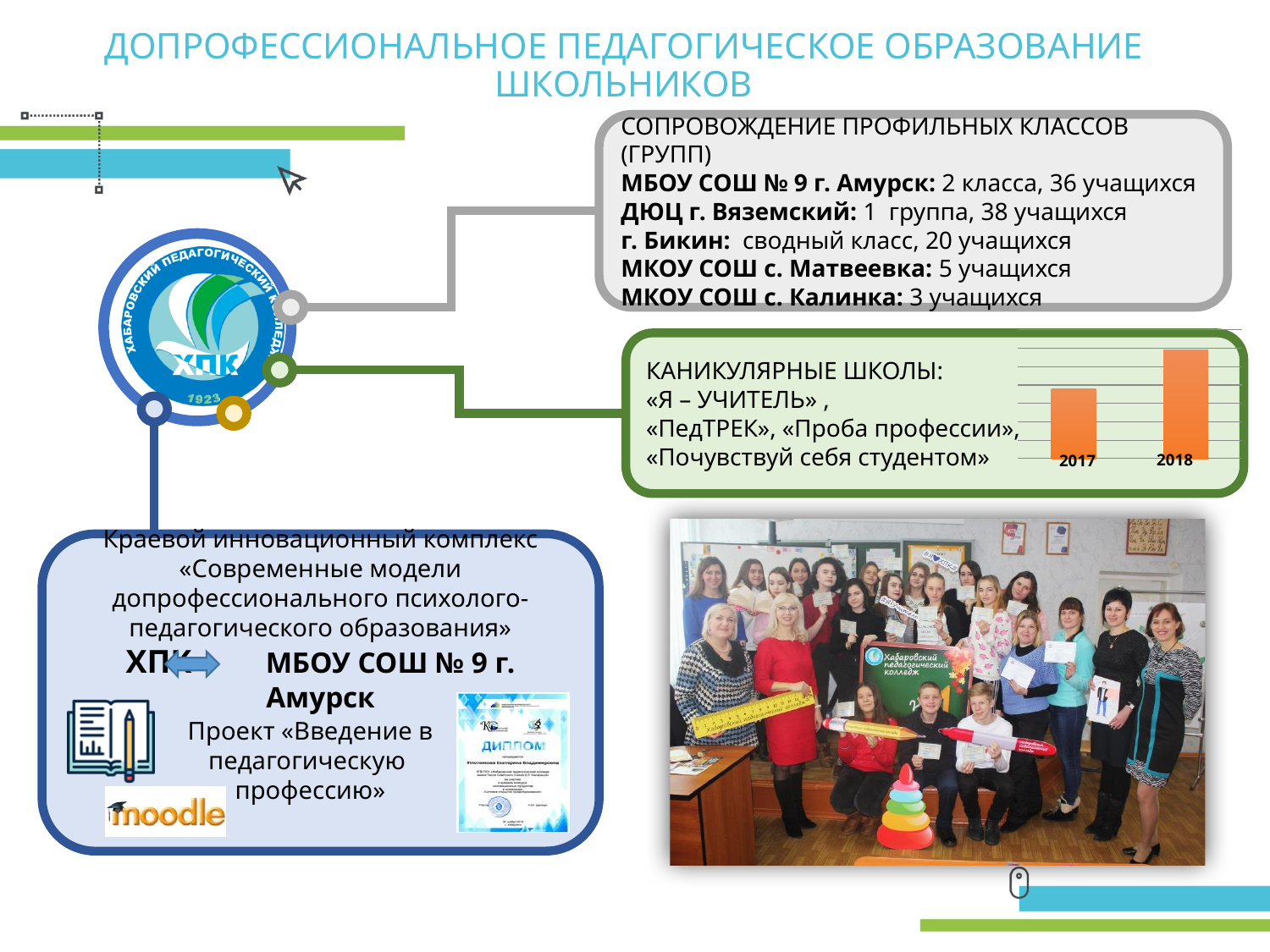
How many categories are shown on the x axis of the bar chart in the green box? 2 What colour are the bars in the bar chart in the green box? orange Which year has the taller bar in the bar chart in the green box? 2018 What are the category labels on the x axis of the bar chart in the green box? 2017 and 2018 In the bar chart in the green box, is the bar for 2018 larger or smaller than the bar for 2017? larger Which year has the shorter bar in the bar chart in the green box? 2017 What kind of chart is shown in the green box about holiday schools (КАНИКУЛЯРНЫЕ ШКОЛЫ)? bar chart Do the values in the bar chart in the green box rise or fall from 2017 to 2018? rise